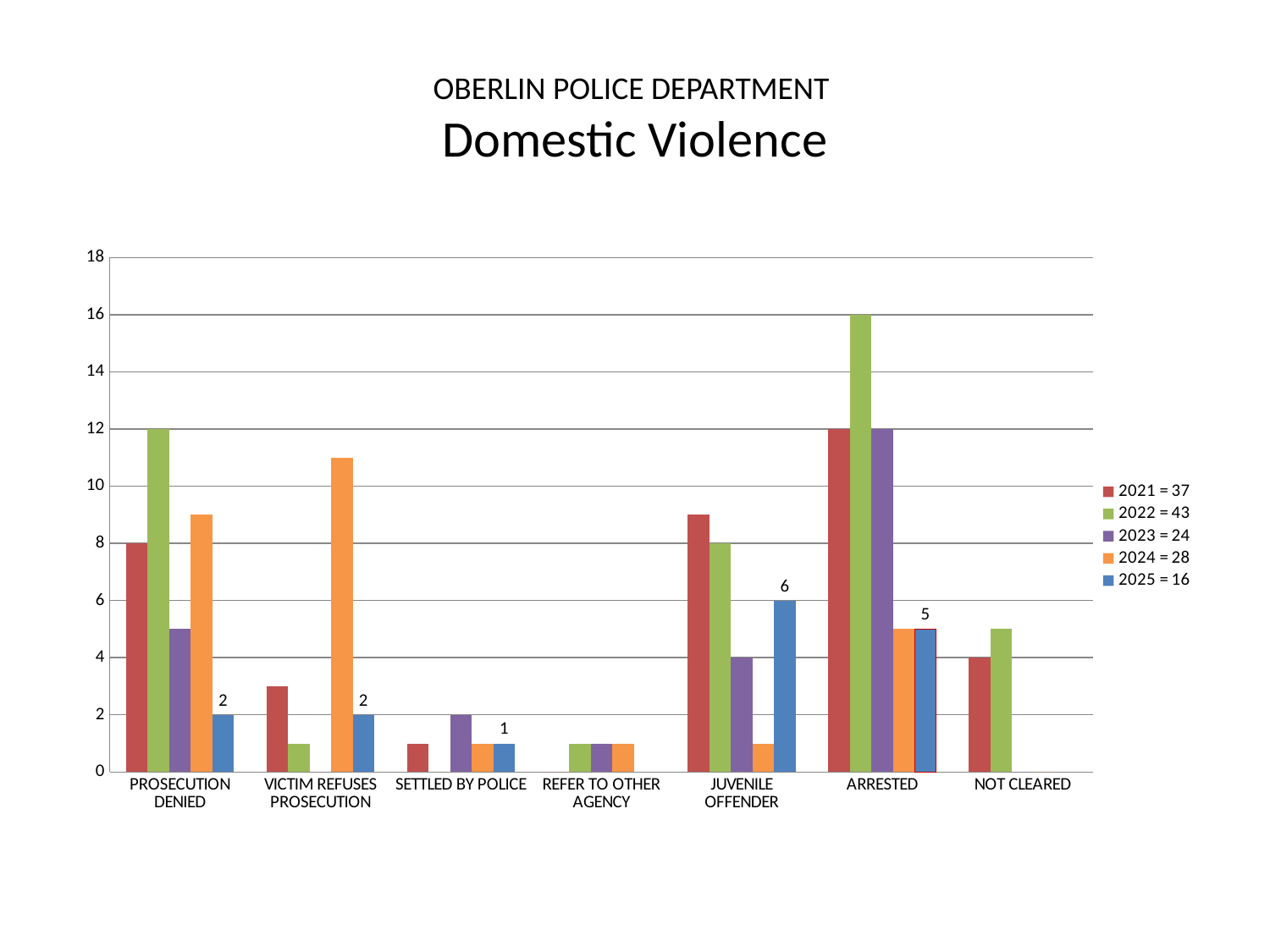
Which category has the highest 2025 value? JUVENILE OFFENDER What is the 2025 value for SETTLED BY POLICE? 1 Which category has the tallest bar in the chart? ARRESTED What type of chart is shown on the slide? bar chart What is the 2022 value for ARRESTED? 16 What is the difference between the 2025 values for JUVENILE OFFENDER and ARRESTED? 1 How many series does the legend list? 5 What is the 2025 value for ARRESTED? 5 What is the 2025 value for JUVENILE OFFENDER? 6 How many categories are shown along the x axis? 7 According to the legend, what is the total for 2022? 43 Is the 2024 value for VICTIM REFUSES PROSECUTION greater or less than 10? greater